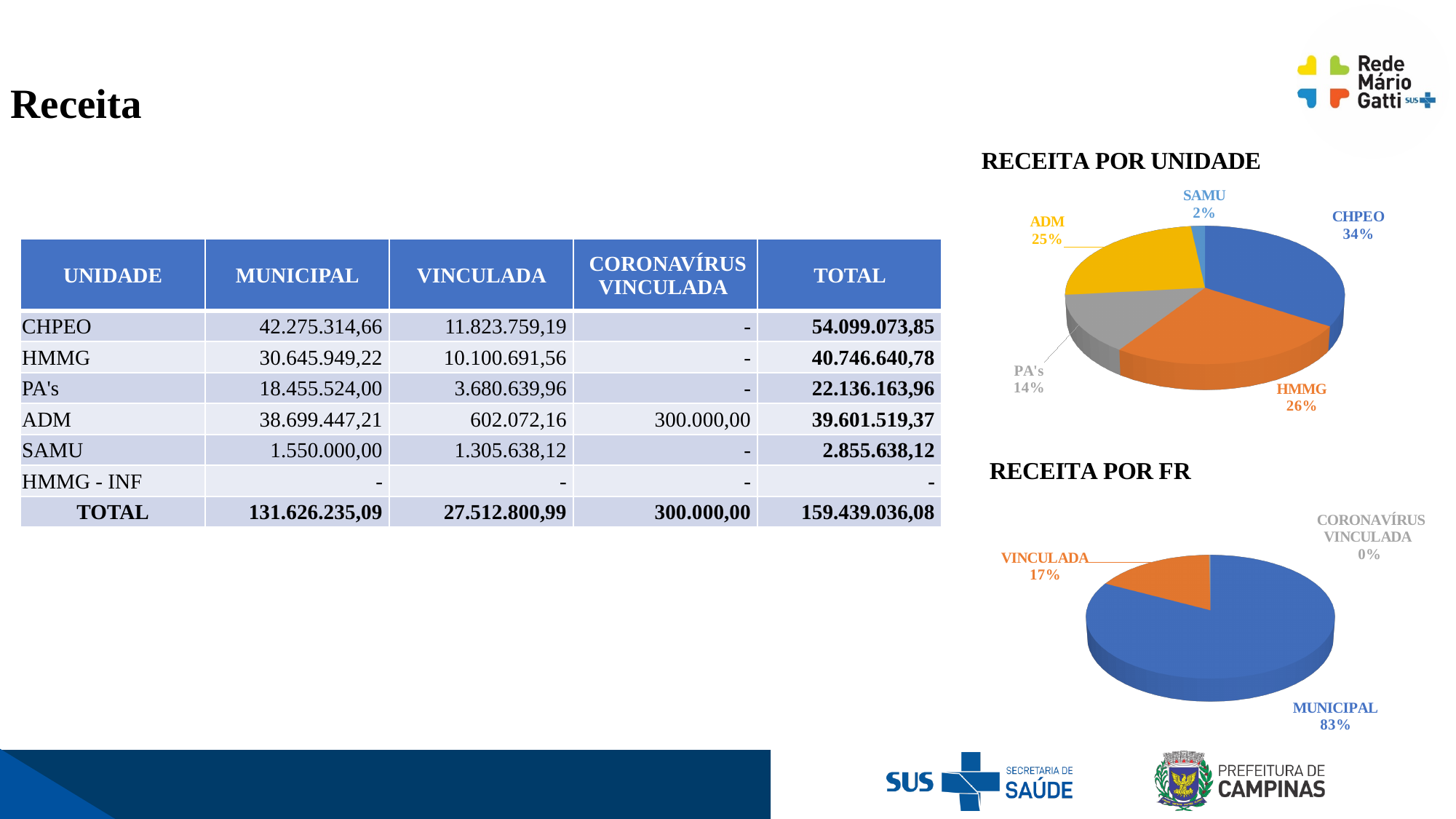
In the 'RECEITA POR UNIDADE' chart, what is the difference in percentage points between HMMG and PA's? 12 In the 'RECEITA POR UNIDADE' chart, which unit has the largest share? CHPEO In the 'RECEITA POR UNIDADE' chart, what share does ADM have? 25% In the 'RECEITA POR FR' chart, what colour is the MUNICIPAL slice? Blue In the 'RECEITA POR UNIDADE' chart, how many slices are there? 5 In the 'RECEITA POR UNIDADE' chart, what share does CHPEO have? 34% In the 'RECEITA POR UNIDADE' chart, which unit has the smallest share? SAMU In the 'RECEITA POR FR' chart, what share does CORONAVÍRUS VINCULADA have? 0% What kind of chart is 'RECEITA POR FR'? Pie chart In the 'RECEITA POR UNIDADE' chart, which is larger, HMMG or ADM? HMMG